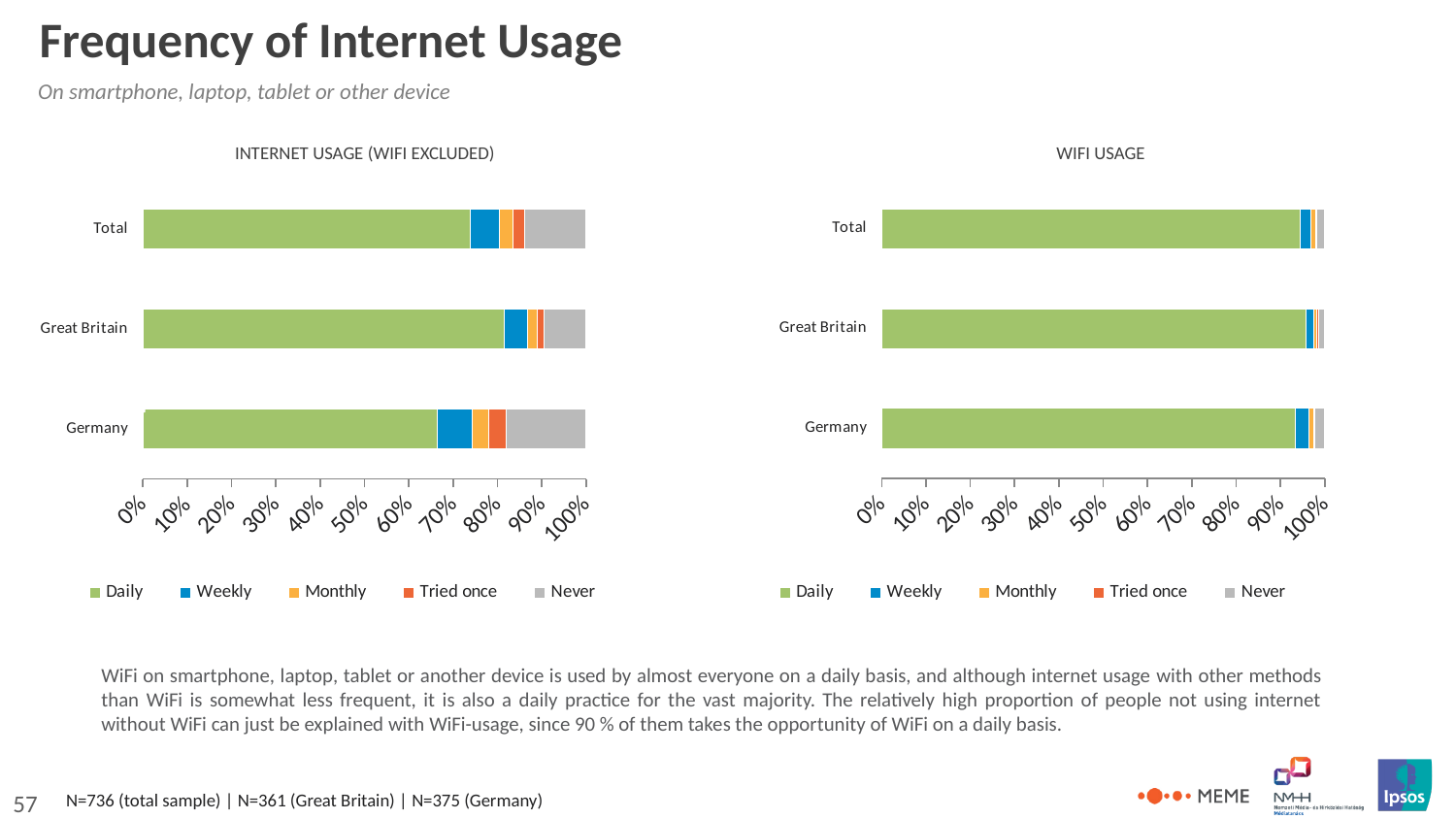
How many series does the legend of the WIFI USAGE chart list? 5 In the INTERNET USAGE (WIFI EXCLUDED) chart, which has a larger Never segment, Germany or Great Britain? Germany In the INTERNET USAGE (WIFI EXCLUDED) chart, is the Daily value for Great Britain greater or less than 70%? greater In the INTERNET USAGE (WIFI EXCLUDED) chart, which category has the largest Daily segment? Great Britain In the WIFI USAGE chart, is the Daily value for Total greater or less than 90%? greater In the INTERNET USAGE (WIFI EXCLUDED) chart, is the Daily value for Germany greater or less than 70%? less Is the Daily segment for Germany larger in the WIFI USAGE chart or in the INTERNET USAGE (WIFI EXCLUDED) chart? WIFI USAGE What is the title of the chart on the right side of the slide? WIFI USAGE In the INTERNET USAGE (WIFI EXCLUDED) chart, which category has the smallest Daily segment? Germany Which legend entry is shown in green in the INTERNET USAGE (WIFI EXCLUDED) chart? Daily How many categories are shown on the INTERNET USAGE (WIFI EXCLUDED) chart? 3 What kind of chart is the INTERNET USAGE (WIFI EXCLUDED) chart? stacked bar chart